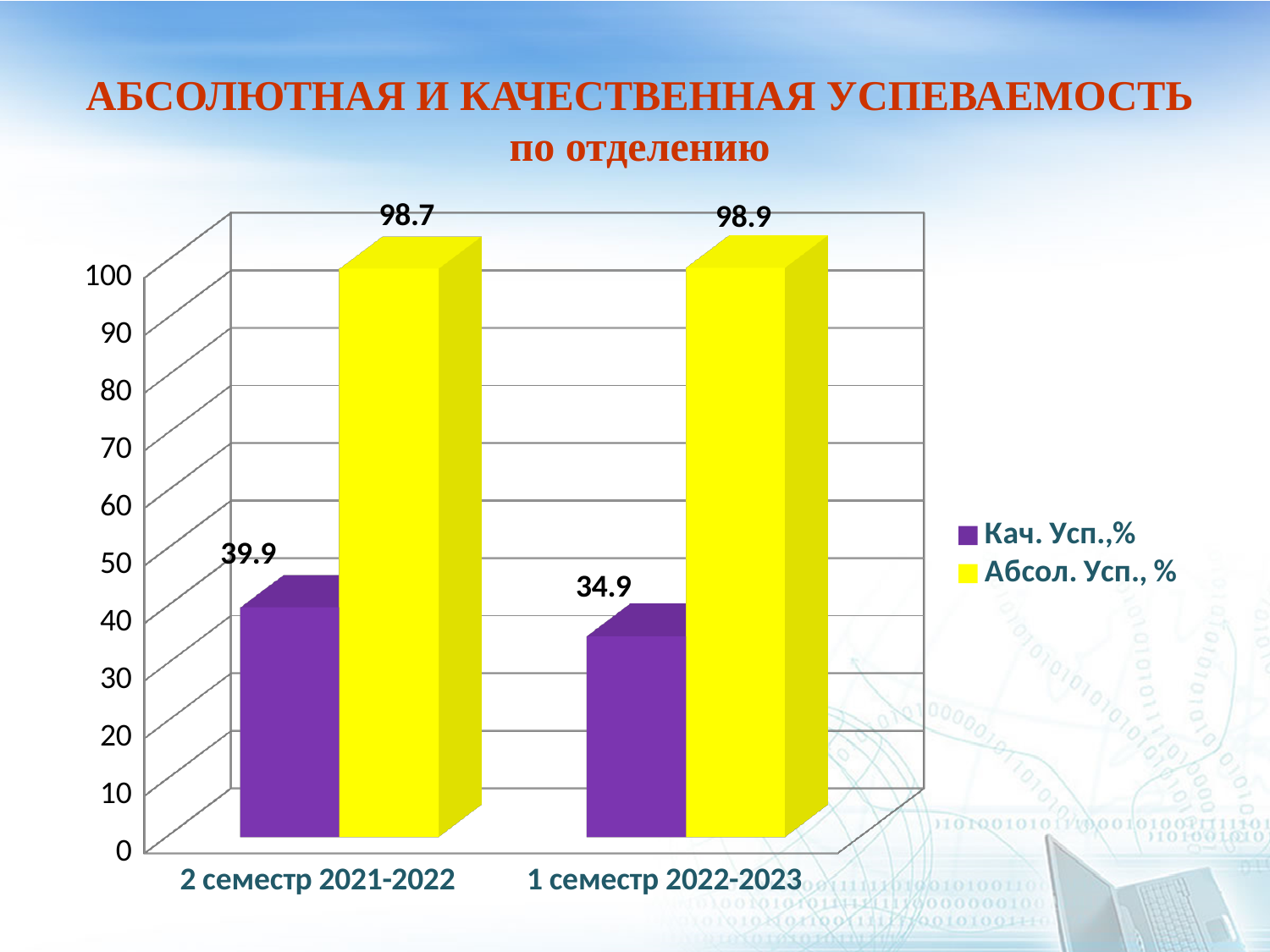
How many categories are shown on the x axis? 2 What kind of chart is shown on the slide? Bar chart What is the difference between the Абсол. Усп., % values for 1 семестр 2022-2023 and 2 семестр 2021-2022? 0.2 What is the value of Абсол. Усп., % for 2 семестр 2021-2022? 98.7 What is the value of Абсол. Усп., % for 1 семестр 2022-2023? 98.9 Which is larger: Кач. Усп.,% for 2 семестр 2021-2022 or Абсол. Усп., % for 2 семестр 2021-2022? Абсол. Усп., % for 2 семестр 2021-2022 What is the value of Кач. Усп.,% for 2 семестр 2021-2022? 39.9 What is the difference between the Кач. Усп.,% values for 2 семестр 2021-2022 and 1 семестр 2022-2023? 5.0 What is the value of Кач. Усп.,% for 1 семестр 2022-2023? 34.9 Which category has the higher value for Кач. Усп.,%? 2 семестр 2021-2022 Does the Кач. Усп.,% series rise or fall from 2 семестр 2021-2022 to 1 семестр 2022-2023? Fall How many series does the legend list? 2